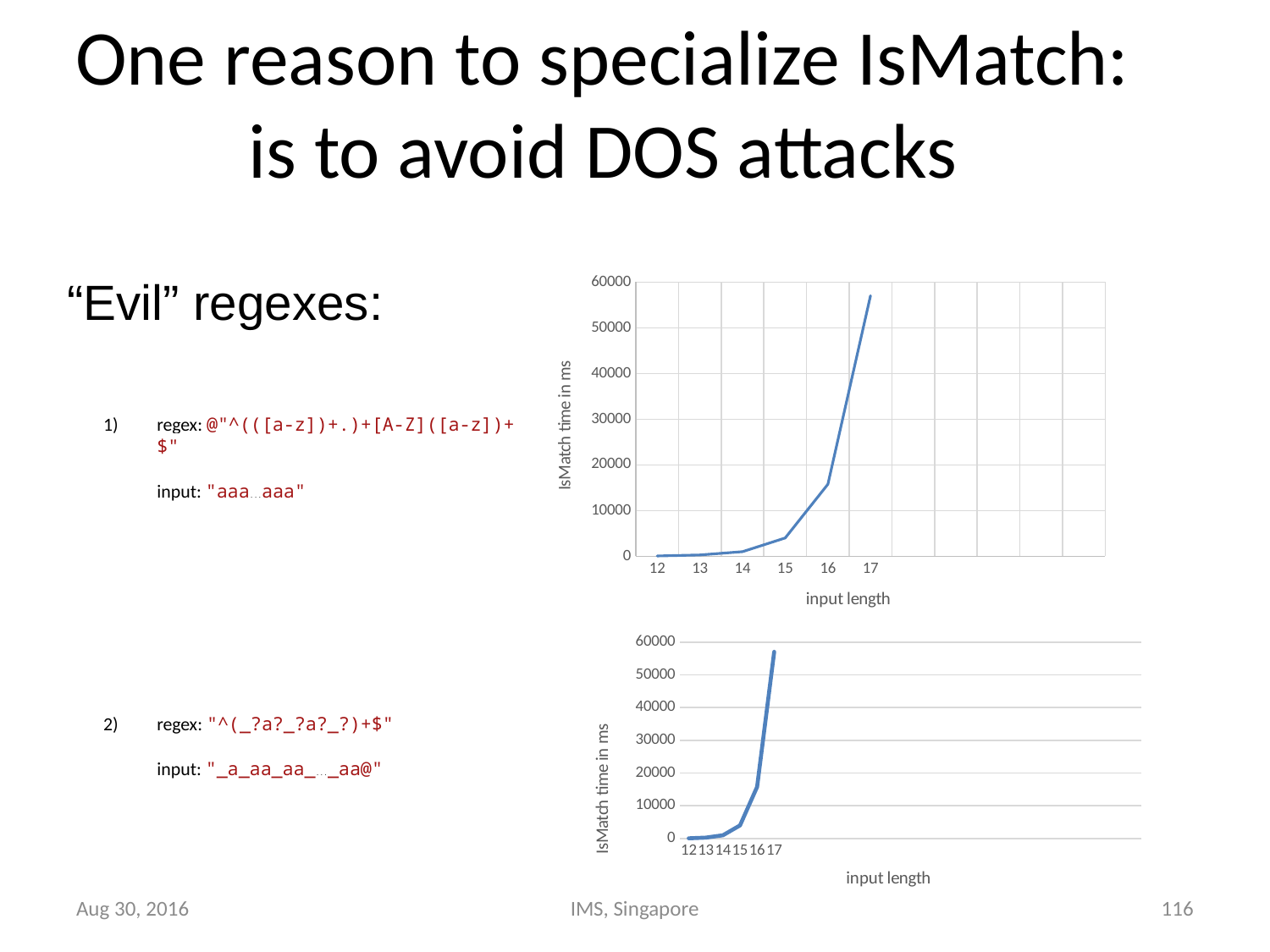
In the top chart, is the IsMatch time for input length 16 greater or less than 10000? greater In the bottom chart, is the IsMatch time for input length 17 greater or less than 50000? greater What type of chart is the top chart on the slide? line chart In the bottom chart, how many input length values are labelled on the x axis? 6 In the top chart, is the IsMatch time for input length 17 greater or less than 50000? greater In the top chart, which input length has the highest IsMatch time? 17 What is the y-axis label of the bottom chart? IsMatch time in ms In the top chart, does the IsMatch time rise or fall as input length increases? rise What type of chart is the bottom chart on the slide? line chart In the top chart, how many input length values are labelled on the x axis? 6